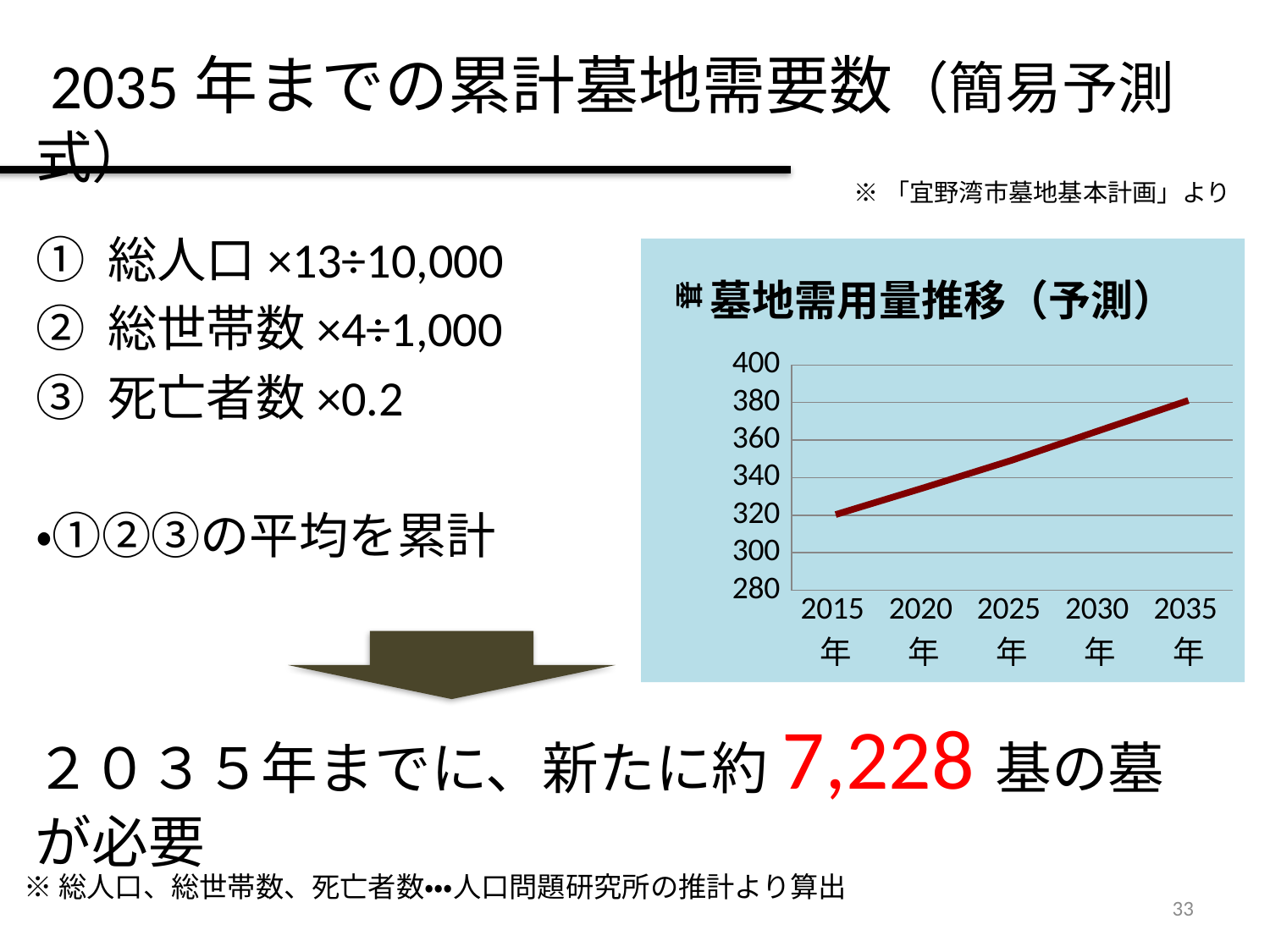
How many years are plotted along the x axis of the chart? 5 What colour is the line in the chart? dark red Which year has the highest value in the chart? 2035年 Is the value for 2025年 greater or less than 340? greater Which year has the lowest value in the chart? 2015年 What kind of chart is shown on the slide? line chart Which is larger in the chart, the value for 2030年 or the value for 2020年? 2030年 What is the title of the chart? 墓地需用量推移（予測） Is the value for 2025年 greater or less than 360? less Do the values in the chart rise or fall from 2015年 to 2035年? rise